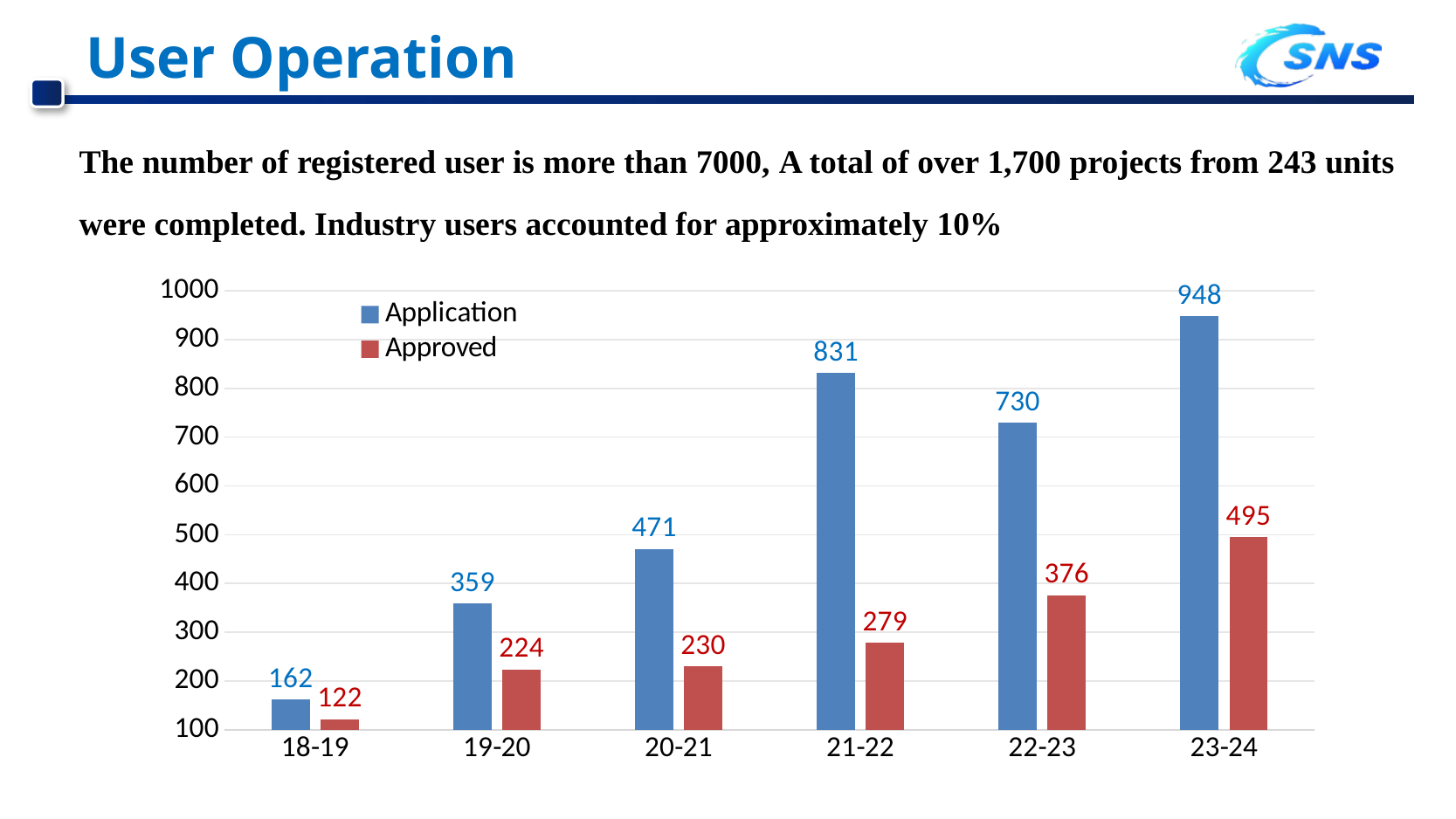
What is the Approved value for 19-20? 224 Which is larger, the Approved value for 20-21 or the Approved value for 21-22? 21-22 How many series does the legend list? 2 Do the Approved values rise or fall from 18-19 to 23-24? rise What is the difference between the Application and Approved values for 23-24? 453 Which period has the highest Application value? 23-24 Which period has the lowest Approved value? 18-19 What kind of chart is shown on the slide? bar chart What is the Application value for 21-22? 831 What is the difference between the Application values for 21-22 and 22-23? 101 Is the Application value for 22-23 greater or less than 700? greater How many periods are shown on the x axis? 6